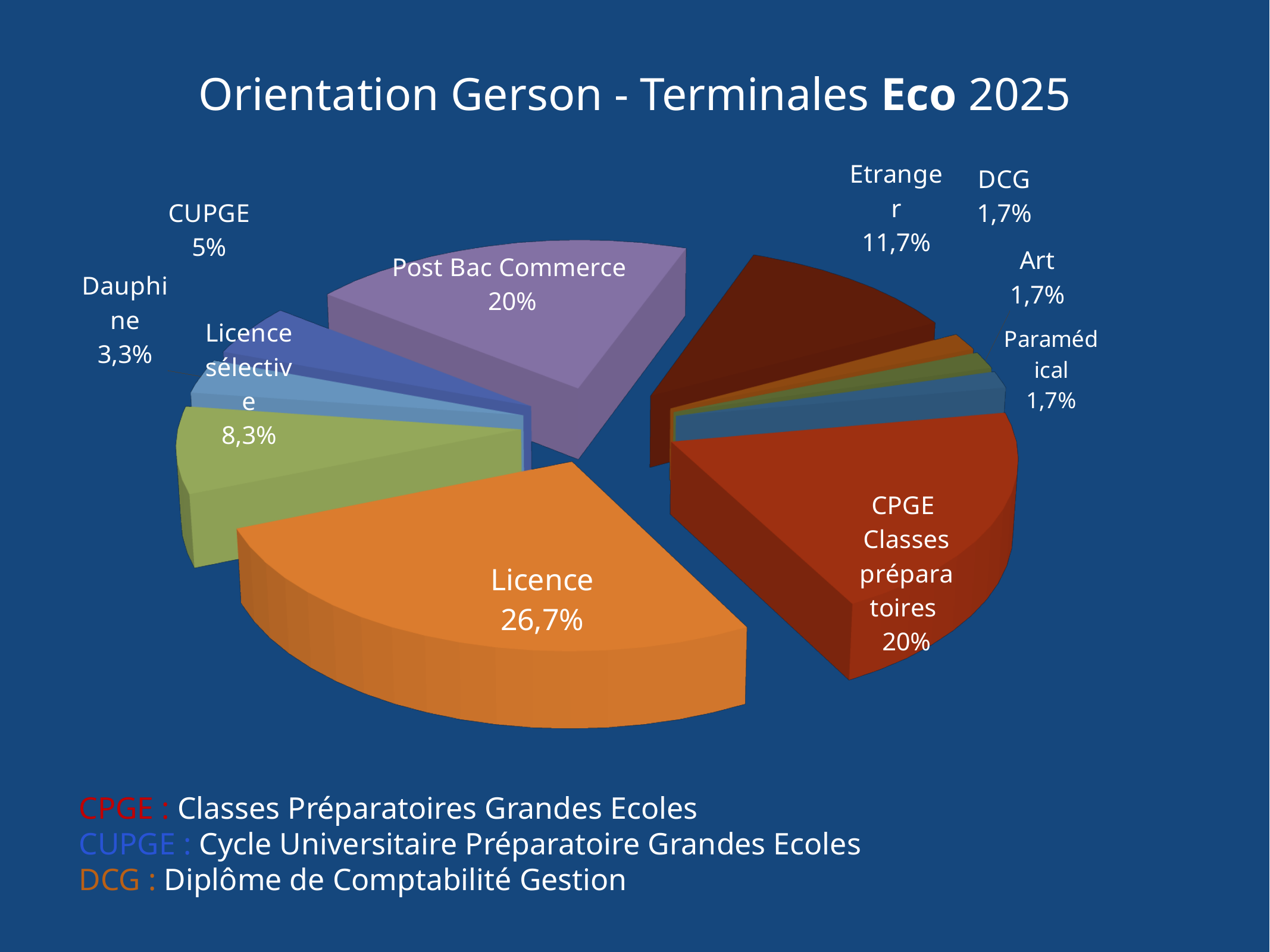
What is the smallest percentage value shown on the chart? 1,7% What is the difference in percentage points between Licence and Post Bac Commerce? 6,7 What percentage is shown for Dauphine? 3,3% What share of the pie does Licence represent? 26,7% What percentage is shown for Etranger? 11,7% Which category has the largest share of the pie? Licence What percentage is shown for Licence sélective? 8,3% What is the title of the chart? Orientation Gerson - Terminales Eco 2025 How many slices does the pie chart have? 10 Which is larger, the share for Etranger or the share for Licence sélective? Etranger What type of chart is shown on the slide? pie chart What percentage is shown for CUPGE? 5%